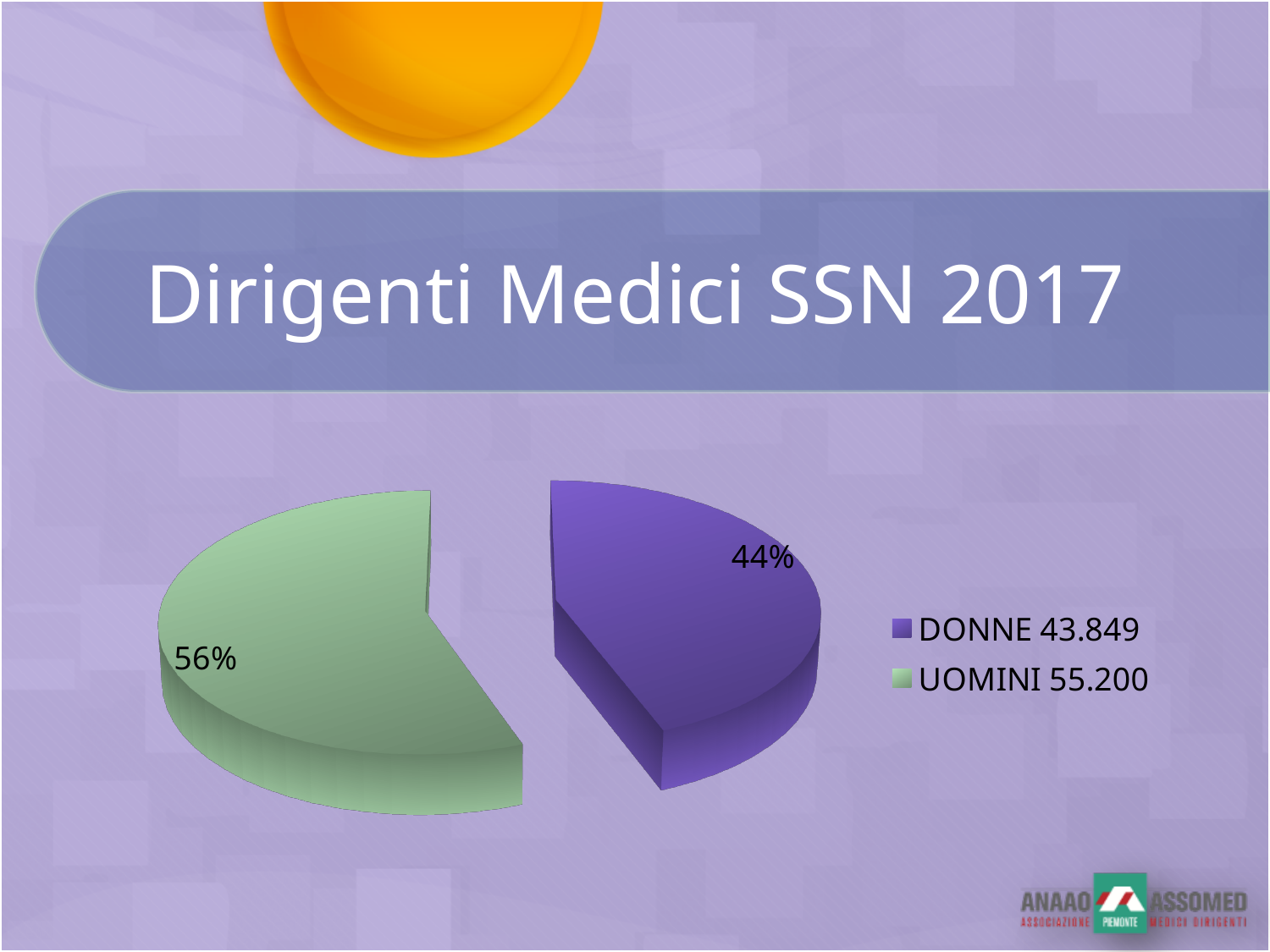
What colour is the UOMINI slice? green Which category has the largest slice? UOMINI Which category has the larger slice, DONNE or UOMINI? UOMINI What percentage share does the DONNE slice have? 44% How many slices does the pie chart have? 2 Which category has the smallest slice? DONNE What percentage share does the UOMINI slice have? 56% What number is shown next to UOMINI in the legend? 55.200 What number is shown next to DONNE in the legend? 43.849 What kind of chart is shown on the slide? pie chart What is the difference in percentage points between the UOMINI and DONNE slices? 12 What is the title shown above the chart? Dirigenti Medici SSN 2017